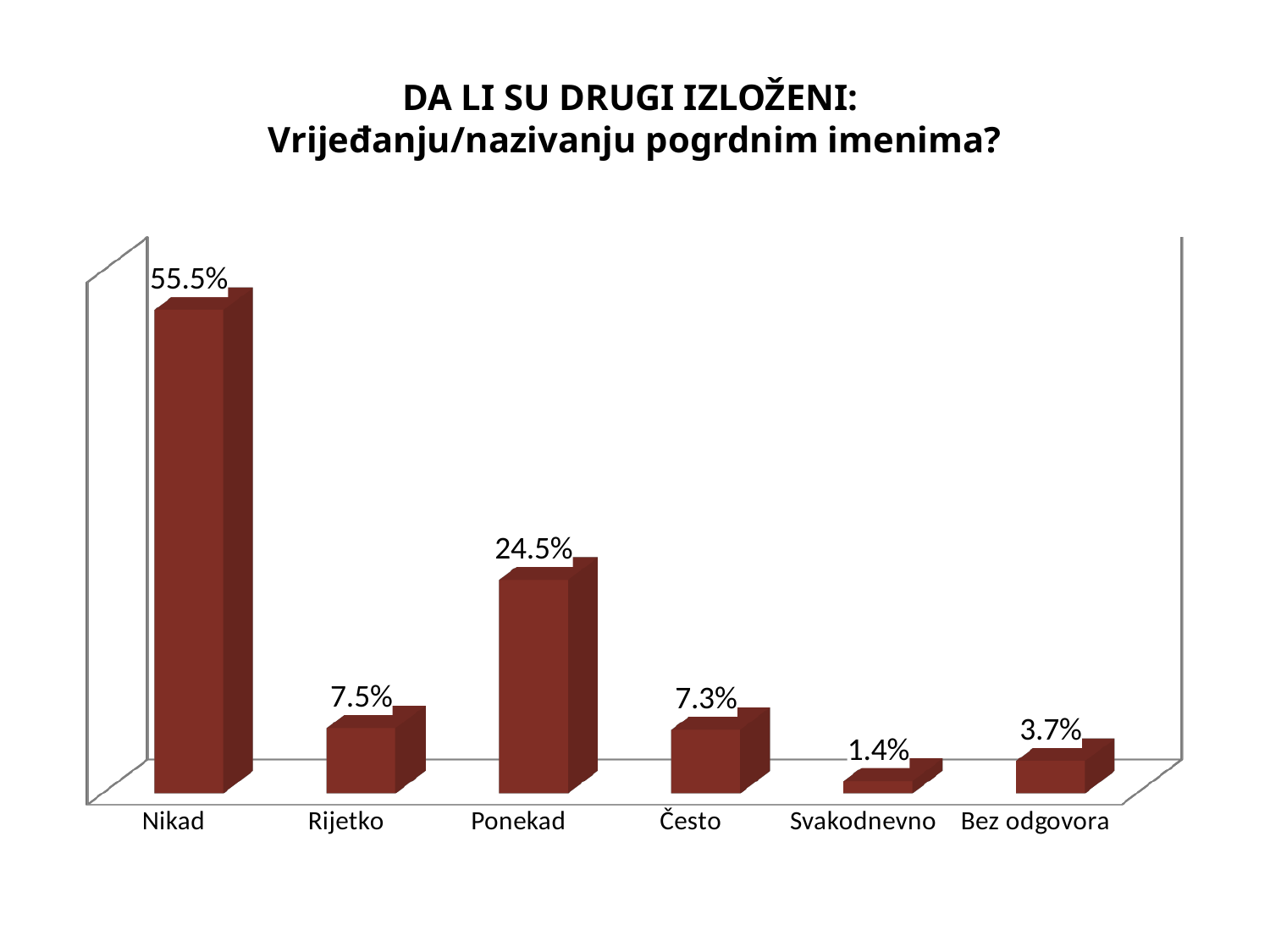
What is the value for Nikad? 55.5% What is the value for Bez odgovora? 3.7% What is the value for Ponekad? 24.5% Which category has the lowest value? Svakodnevno What kind of chart is shown on the slide? Bar chart What is the difference between the values for Rijetko and Često? 0.2% Which category has the highest value? Nikad What is the difference between the values for Nikad and Ponekad? 31.0% What is the title of the chart? DA LI SU DRUGI IZLOŽENI: Vrijeđanju/nazivanju pogrdnim imenima? Which is larger, the value for Ponekad or the value for Bez odgovora? Ponekad What is the value for Svakodnevno? 1.4% How many categories are shown on the x axis? 6